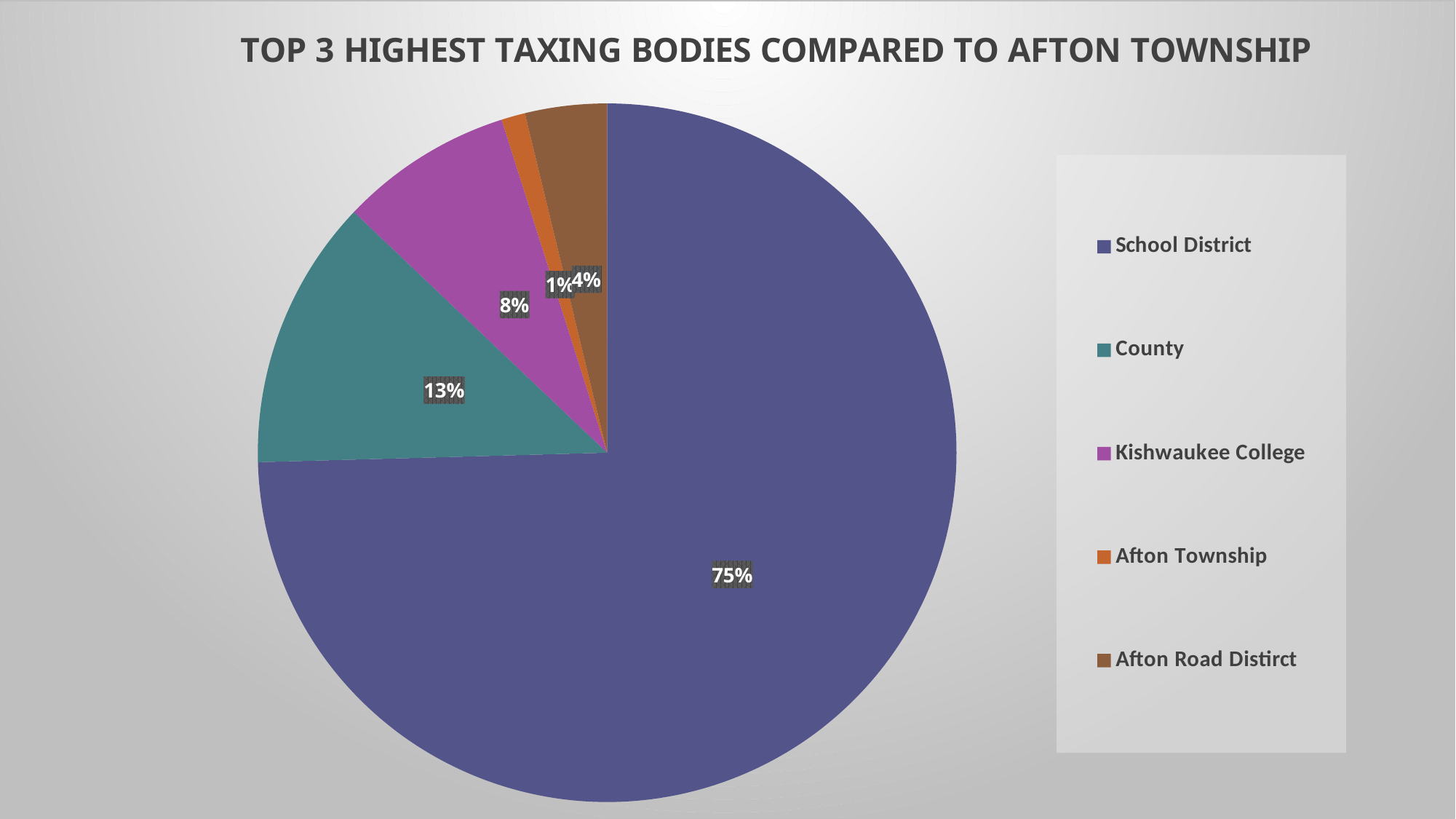
What share of the pie does School District have? 75% Which category has the largest slice of the pie? School District What kind of chart is shown on the slide? Pie chart What share of the pie does Afton Road Distirct have? 4% What is the difference in percentage points between the School District and County slices? 62 What share of the pie does County have? 13% How many slices does the pie chart have? 5 What is the title of the chart? TOP 3 HIGHEST TAXING BODIES COMPARED TO AFTON TOWNSHIP Which is larger, the County slice or the Kishwaukee College slice? County Which category has the smallest slice of the pie? Afton Township